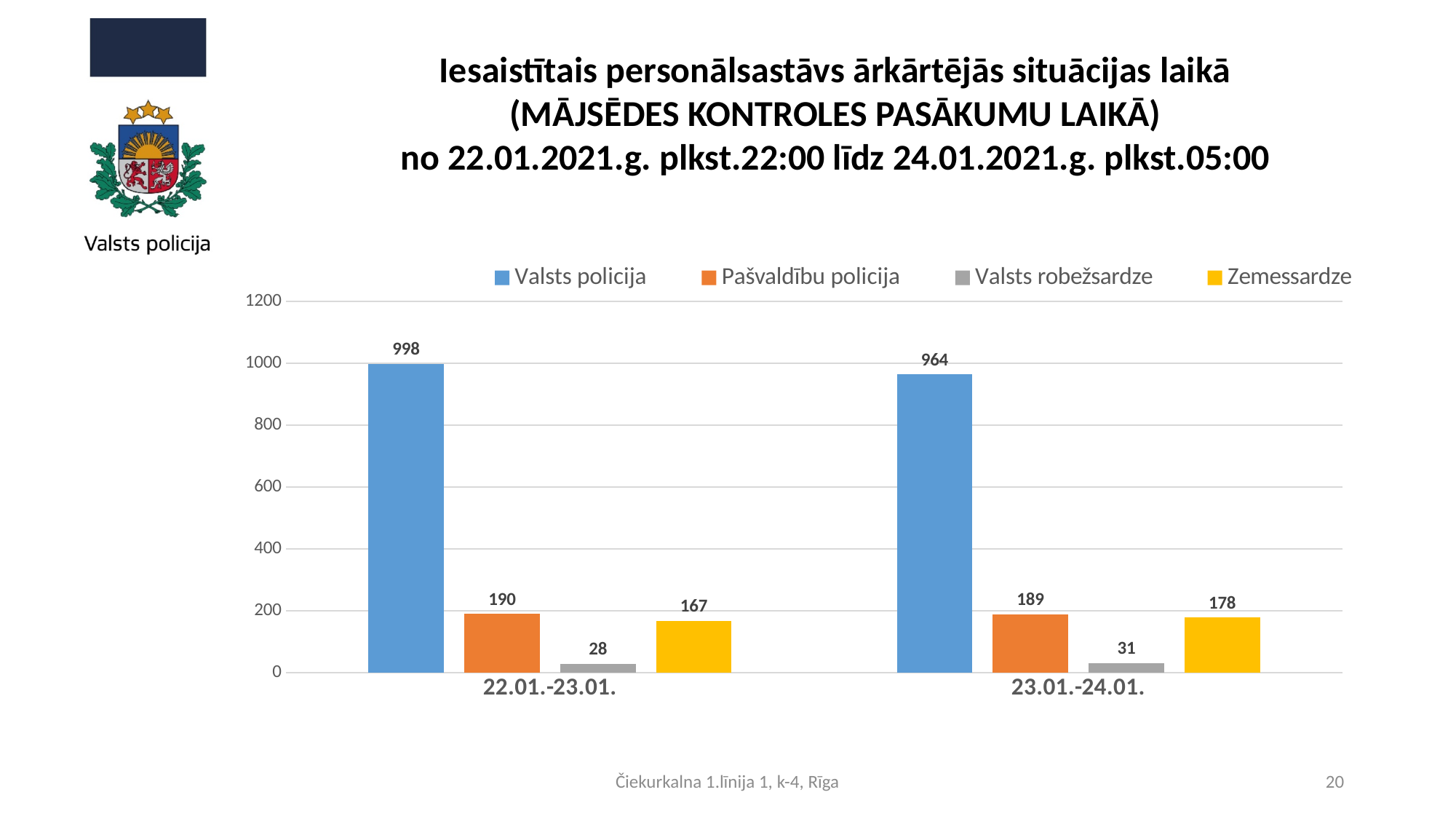
Which series has the lowest value in the 22.01.-23.01. period? Valsts robežsardze Which is larger: Pašvaldību policija in 22.01.-23.01. or Zemessardze in 22.01.-23.01.? Pašvaldību policija in 22.01.-23.01. How many series does the legend list? 4 What is the difference between the Valsts policija values for 22.01.-23.01. and 23.01.-24.01.? 34 What is the value for Valsts robežsardze in the 22.01.-23.01. period? 28 Which series has the highest value in the 23.01.-24.01. period? Valsts policija Which colour represents Zemessardze in the chart? yellow How many periods (categories) are shown on the x axis? 2 What is the value for Valsts policija in the 22.01.-23.01. period? 998 Is the value for Valsts policija in 23.01.-24.01. greater or less than 800? greater What kind of chart is shown on the slide? bar chart What is the value for Zemessardze in the 23.01.-24.01. period? 178